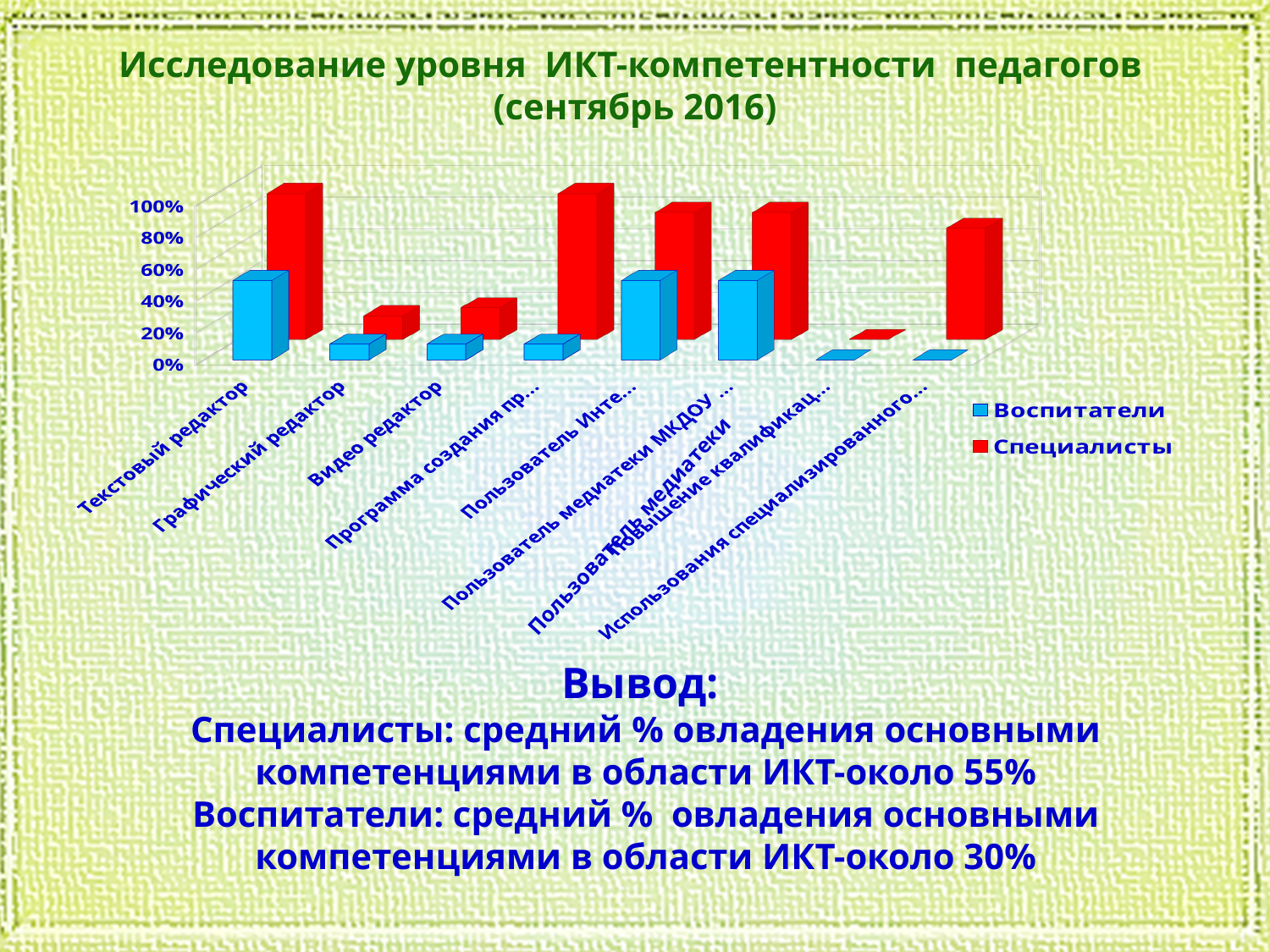
What are the two series named in the legend? Воспитатели and Специалисты Is the Воспитатели value for Текстовый редактор greater or less than 20%? greater For Видео редактор, which series has the larger value, Воспитатели or Специалисты? Специалисты Which category has the lowest value for the Специалисты series? Повышение квалификац... Which colour represents the Специалисты series? red What kind of chart is shown on the slide? bar chart How many categories are plotted along the x axis? 8 For Текстовый редактор, which series has the larger value, Воспитатели or Специалисты? Специалисты Is the Воспитатели value for Видео редактор greater or less than 40%? less Is the Специалисты value for Графический редактор greater or less than 60%? less How many series does the legend list? 2